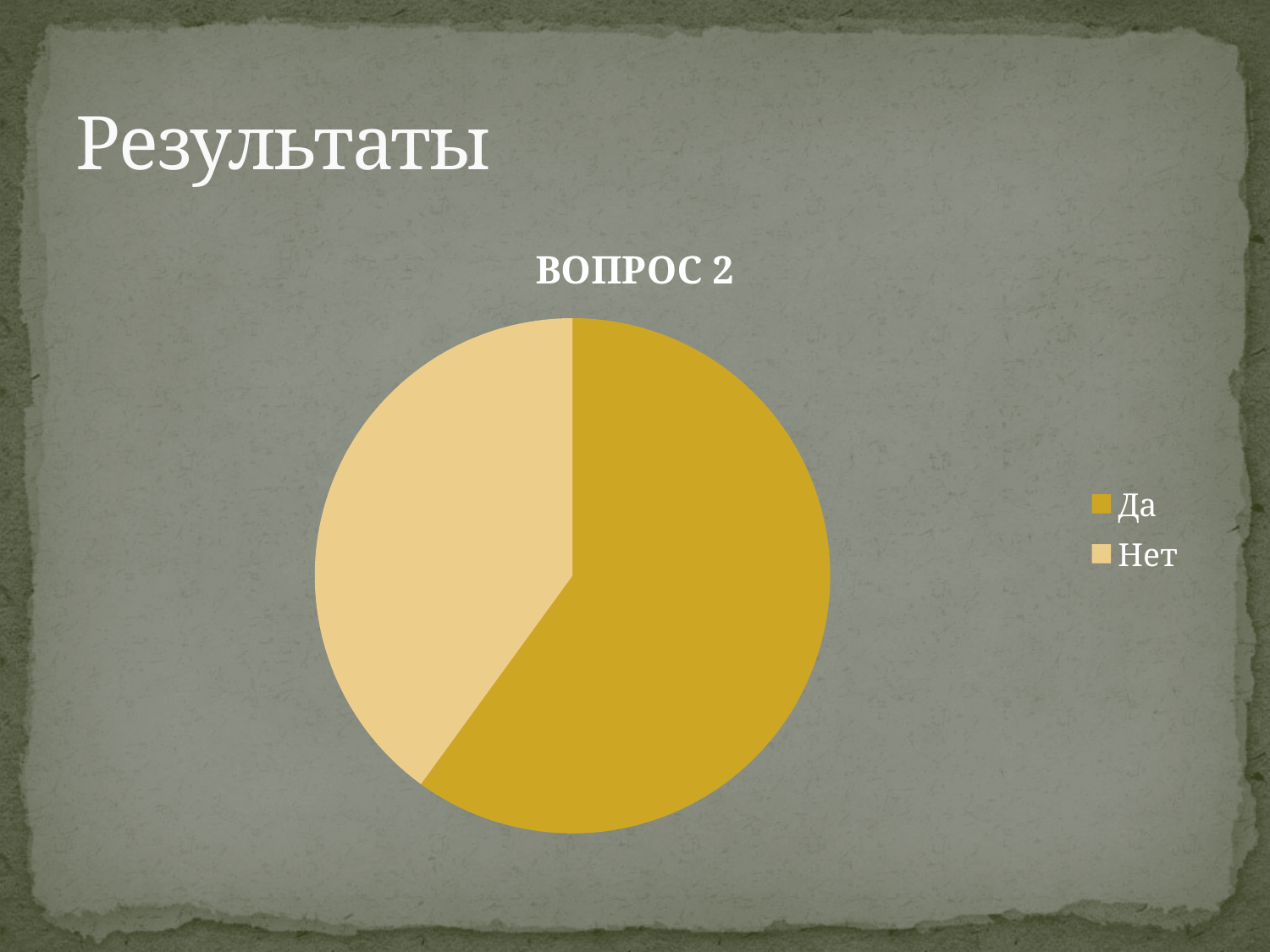
Which category has the smallest slice of the pie? Нет What is the title of the chart? ВОПРОС 2 Which slice is larger, Да or Нет? Да How many slices does the pie chart have? 2 Which category has the largest slice of the pie? Да Which legend entry is shown in the darker gold colour? Да How many entries does the legend list? 2 What kind of chart is shown on the slide? pie chart Does the Да slice take up more or less than half of the pie? more